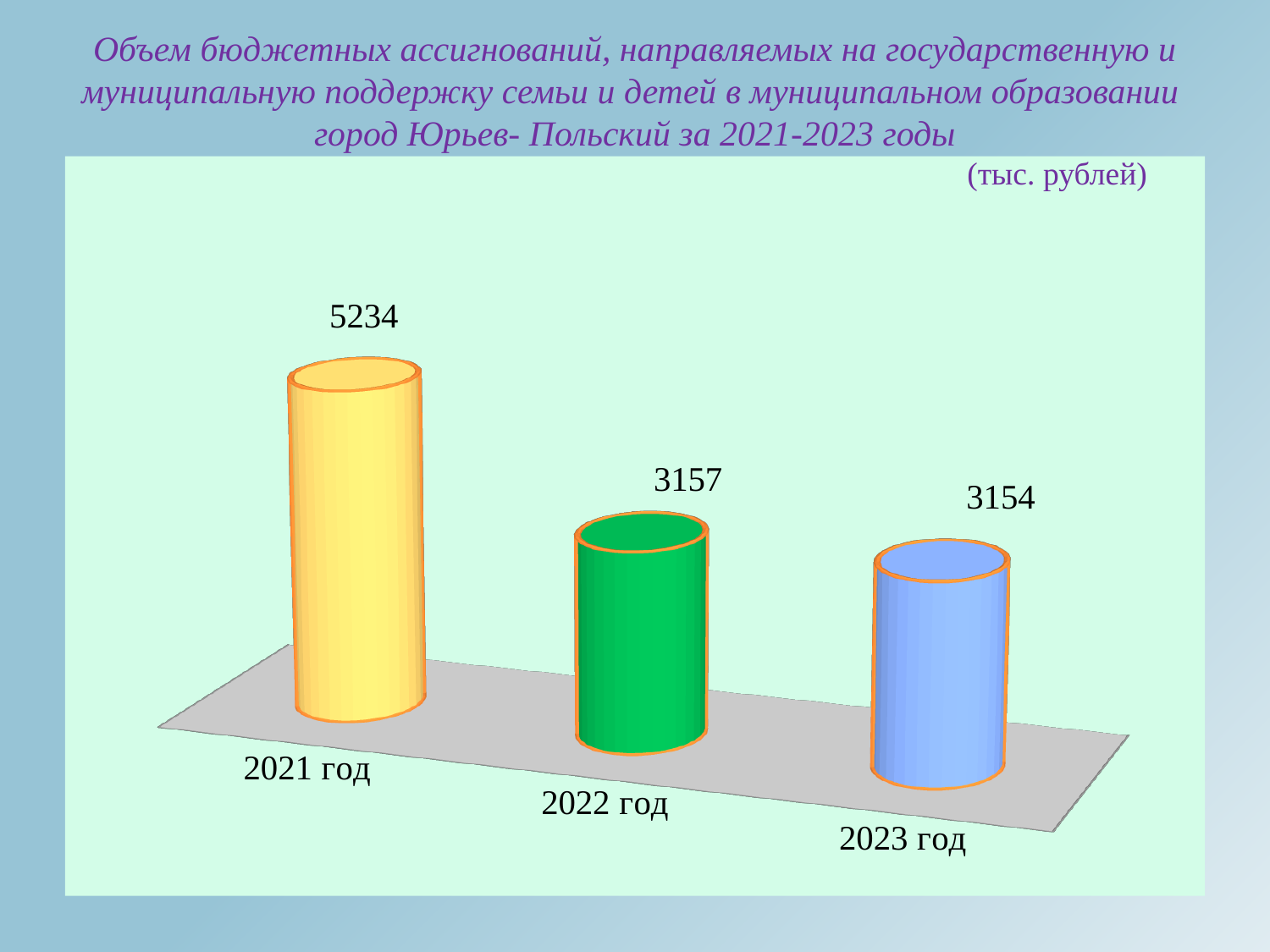
What is the value for 2023 год? 3154 How many years are shown on the chart? 3 What is the difference between the values for 2022 год and 2023 год? 3 What is the value for 2021 год? 5234 What kind of chart is shown on the slide? bar chart Do the values rise or fall from 2021 год to 2023 год? fall In what units are the values on the chart given? тыс. рублей Which year has the highest value? 2021 год What is the difference between the values for 2021 год and 2023 год? 2080 What is the value for 2022 год? 3157 What is the difference between the values for 2021 год and 2022 год? 2077 What colour is the bar for 2022 год? green